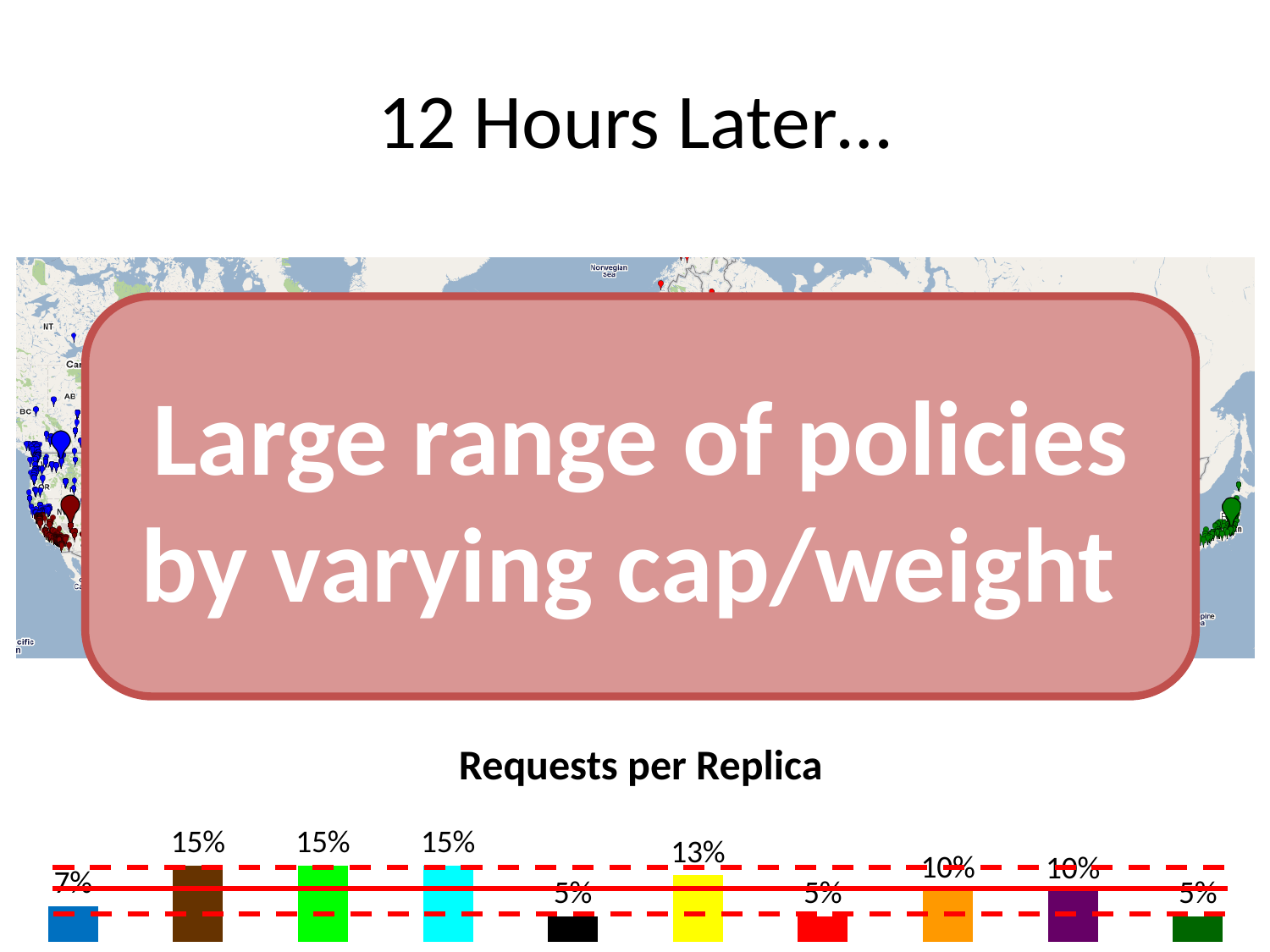
In the "Requests per Replica" chart, what is the difference between the brown bar (15%) and the black bar (5%)? 10% What kind of chart is shown under the title "Requests per Replica"? bar chart In the "Requests per Replica" chart, what value is labelled on the yellow bar? 13% In the "Requests per Replica" chart, what value is labelled on the last (dark green) bar on the right? 5% How many bars are plotted in the "Requests per Replica" chart? 10 In the "Requests per Replica" chart, which is larger: the yellow bar or the purple bar? the yellow bar What is the title of the chart at the bottom of the slide? Requests per Replica In the "Requests per Replica" chart, how many bars are labelled 15%? 3 In the "Requests per Replica" chart, what value is labelled on the first (blue) bar from the left? 7% In the "Requests per Replica" chart, what value is labelled on the orange bar? 10% In the "Requests per Replica" chart, what is the lowest value labelled on any bar? 5% In the "Requests per Replica" chart, what is the highest value labelled on any bar? 15%